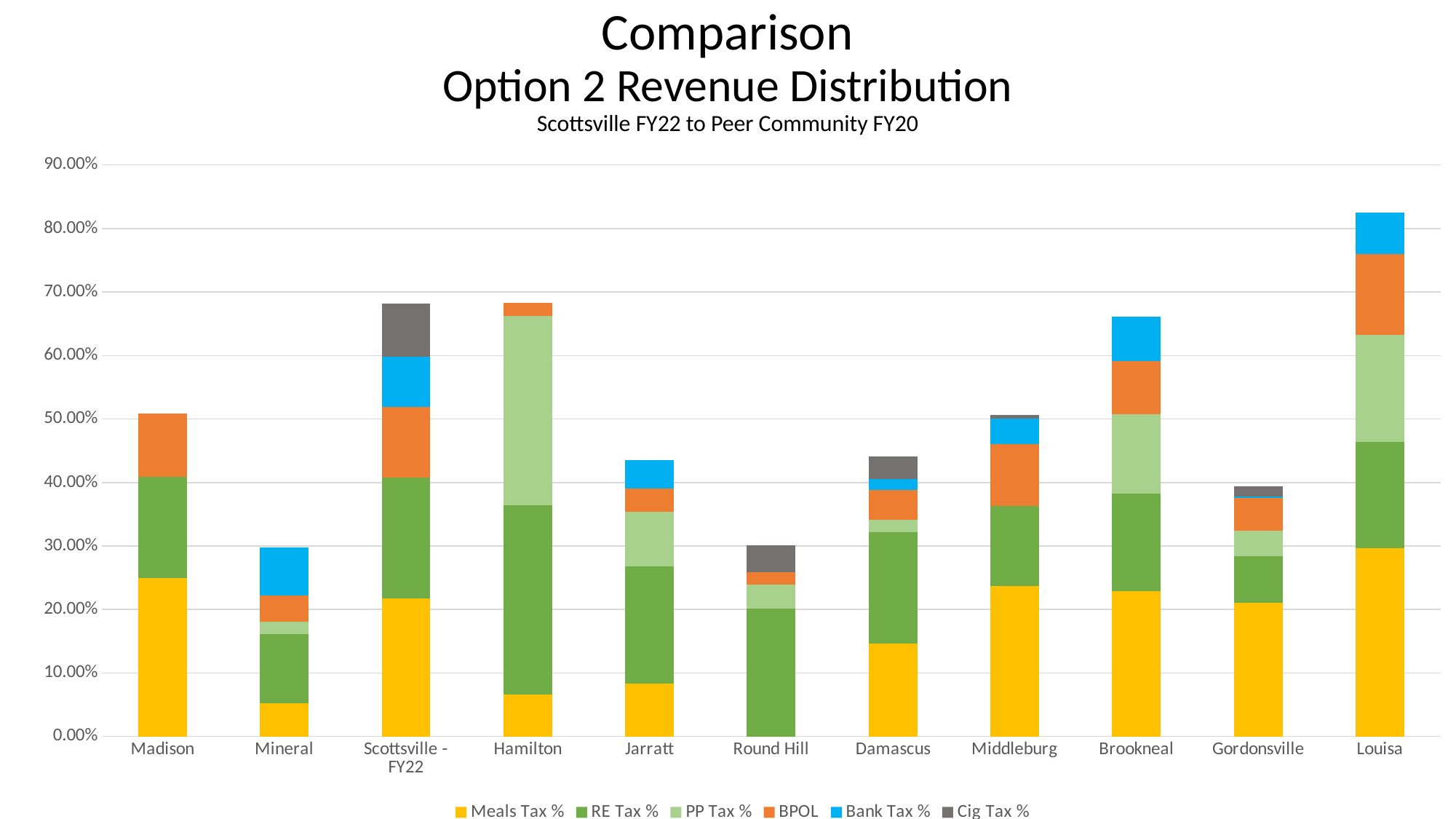
What is the subtitle shown below the chart title? Scottsville FY22 to Peer Community FY20 Which community's bar has no Meals Tax % segment? Round Hill What kind of chart is shown on the slide? Stacked bar chart Is the total for Round Hill greater or less than 40.00%? less Which community has the highest total stacked bar? Louisa Is the total for Louisa greater or less than 80.00%? greater Is the total for Mineral greater or less than 40.00%? less How many communities are shown along the x axis? 11 Which community has the largest PP Tax % segment? Hamilton How many series does the legend list? 6 Which has the larger total bar, Hamilton or Jarratt? Hamilton